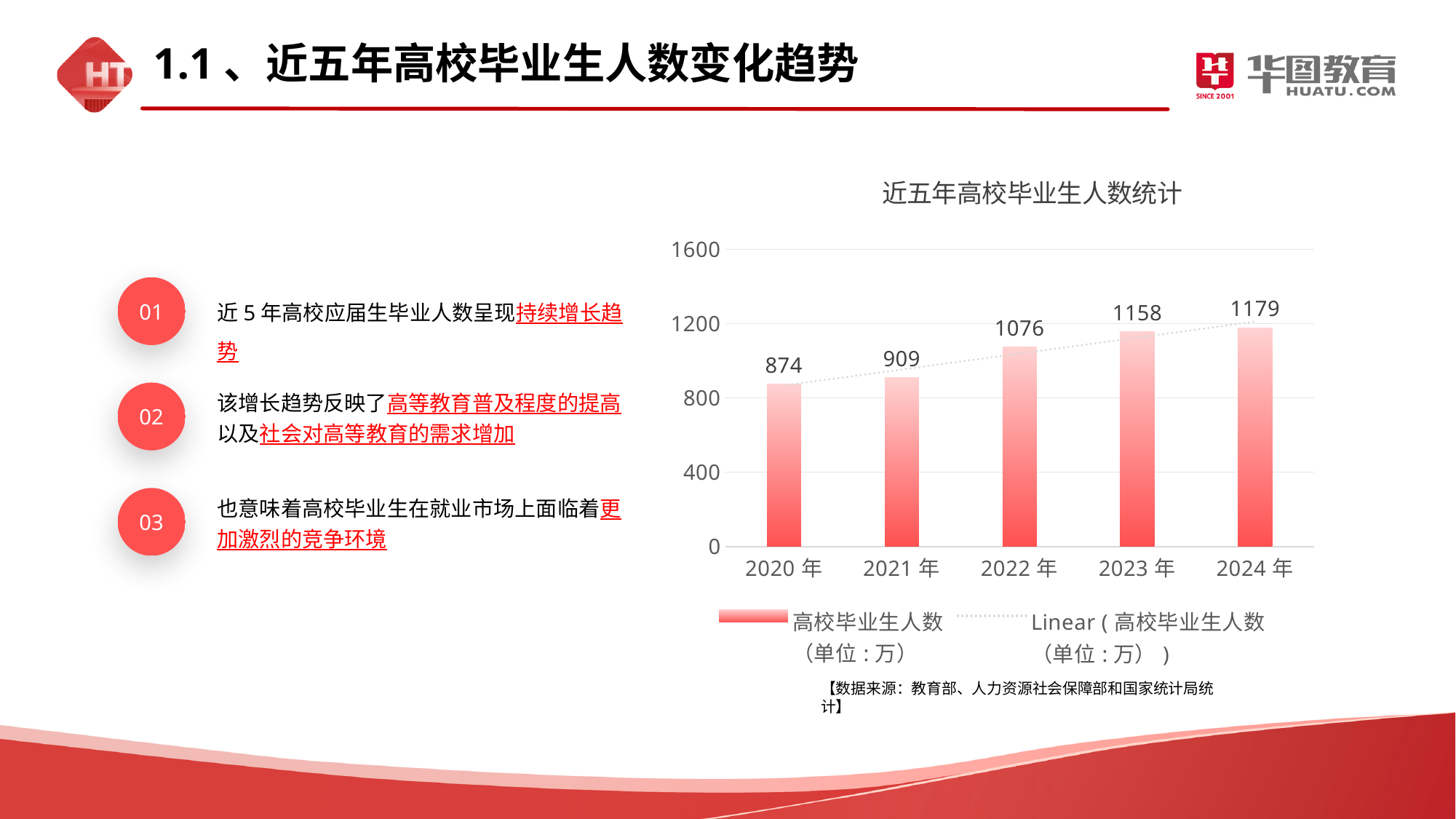
Which year has the lowest value? 2020 年 Do the values rise or fall from 2020 年 to 2024 年? rise How many entries does the legend list? 2 What is the difference between the values for 2023 年 and 2022 年? 82 What is the value for 2022 年? 1076 What is the difference between the values for 2024 年 and 2020 年? 305 How many years are shown on the x axis? 5 What kind of chart is this? bar chart Which is larger, the value for 2021 年 or the value for 2023 年? 2023 年 Is the value for 2021 年 greater or less than 800? greater Which year has the highest value? 2024 年 What is the value for 2020 年? 874